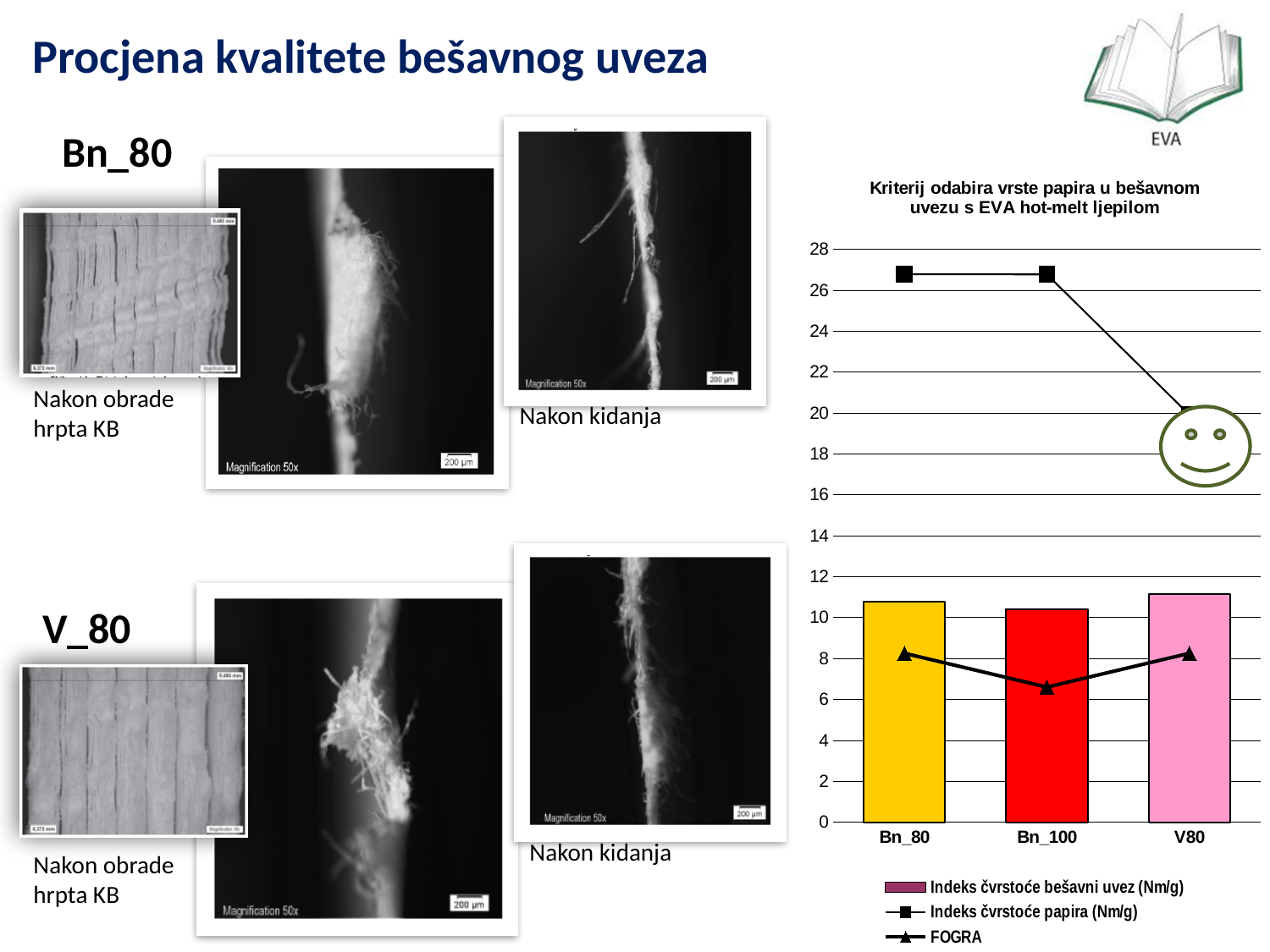
How many series does the chart legend list? 3 Is the Indeks čvrstoće bešavni uvez bar for Bn_80 greater or less than 10? greater What is the title of the chart? Kriterij odabira vrste papira u bešavnom uvezu s EVA hot-melt ljepilom Which category has the highest bar for Indeks čvrstoće bešavni uvez (Nm/g)? V80 Which category has the lowest bar for Indeks čvrstoće bešavni uvez (Nm/g)? Bn_100 Is the Indeks čvrstoće papira value for Bn_80 greater or less than 26? greater Which category has the lowest FOGRA value? Bn_100 Is the FOGRA value for Bn_100 greater or less than 8? less What kind of chart is shown on the slide? A combined bar and line chart Does the Indeks čvrstoće papira line rise or fall from Bn_100 to V80? fall How many categories are shown on the x axis of the chart? 3